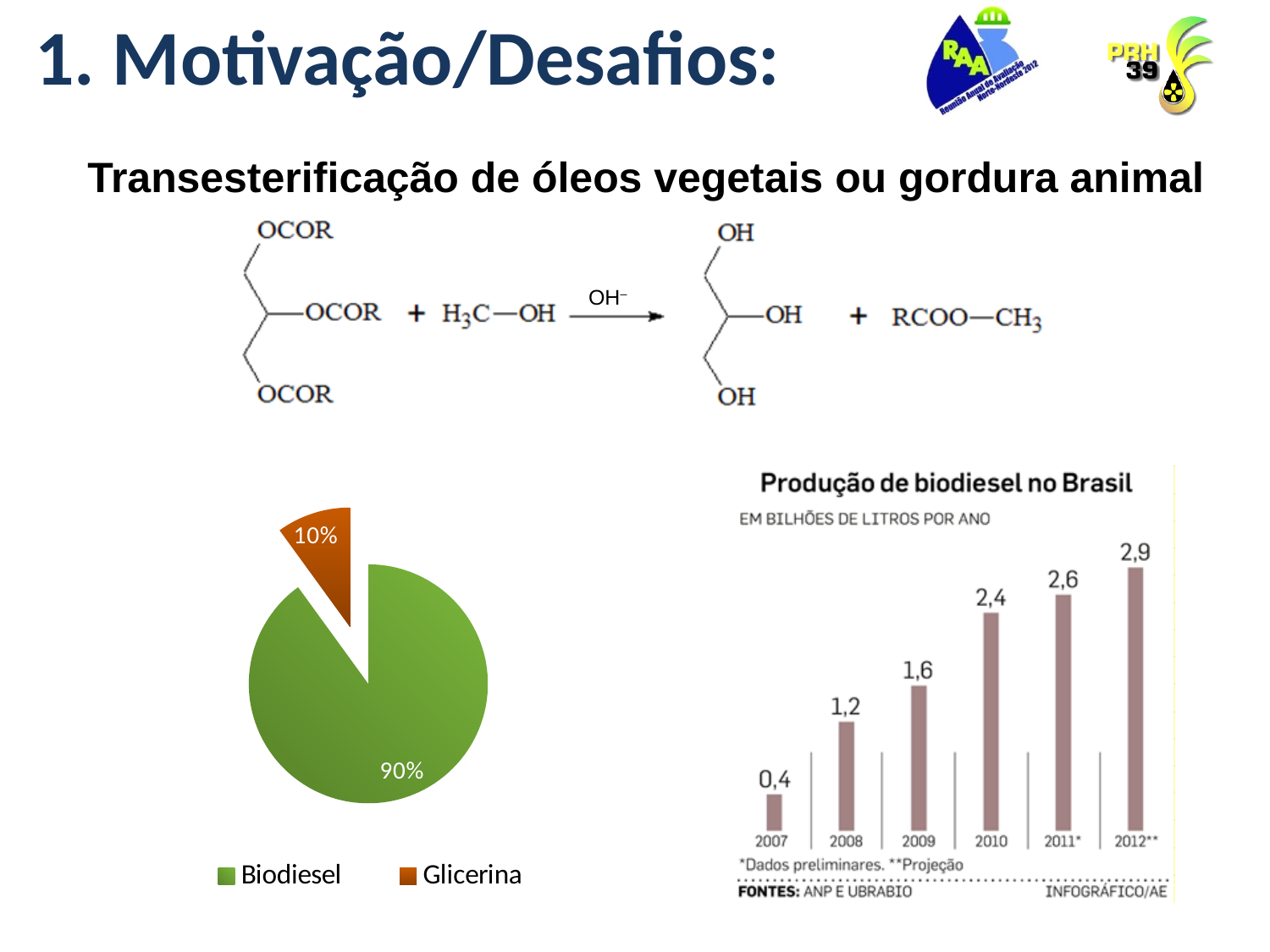
In the chart 'Produção de biodiesel no Brasil', what is the value for 2007? 0,4 In the chart 'Produção de biodiesel no Brasil', do the values rise or fall from 2007 to 2012? Rise In the chart 'Produção de biodiesel no Brasil', how many years are shown? 6 In the pie chart on the left, what share does Biodiesel have? 90% In the chart 'Produção de biodiesel no Brasil', which year has the highest value? 2012** What kind of chart is the chart on the left of the slide? Pie chart In the chart 'Produção de biodiesel no Brasil', which year has the lowest value? 2007 In the chart 'Produção de biodiesel no Brasil', what is the difference between the values for 2009 and 2008? 0,4 In the chart 'Produção de biodiesel no Brasil', what is the value for 2010? 2,4 In the pie chart on the left, which slice is larger, Biodiesel or Glicerina? Biodiesel In the pie chart on the left, what share does Glicerina have? 10% In the pie chart on the left, how many entries does the legend list? 2